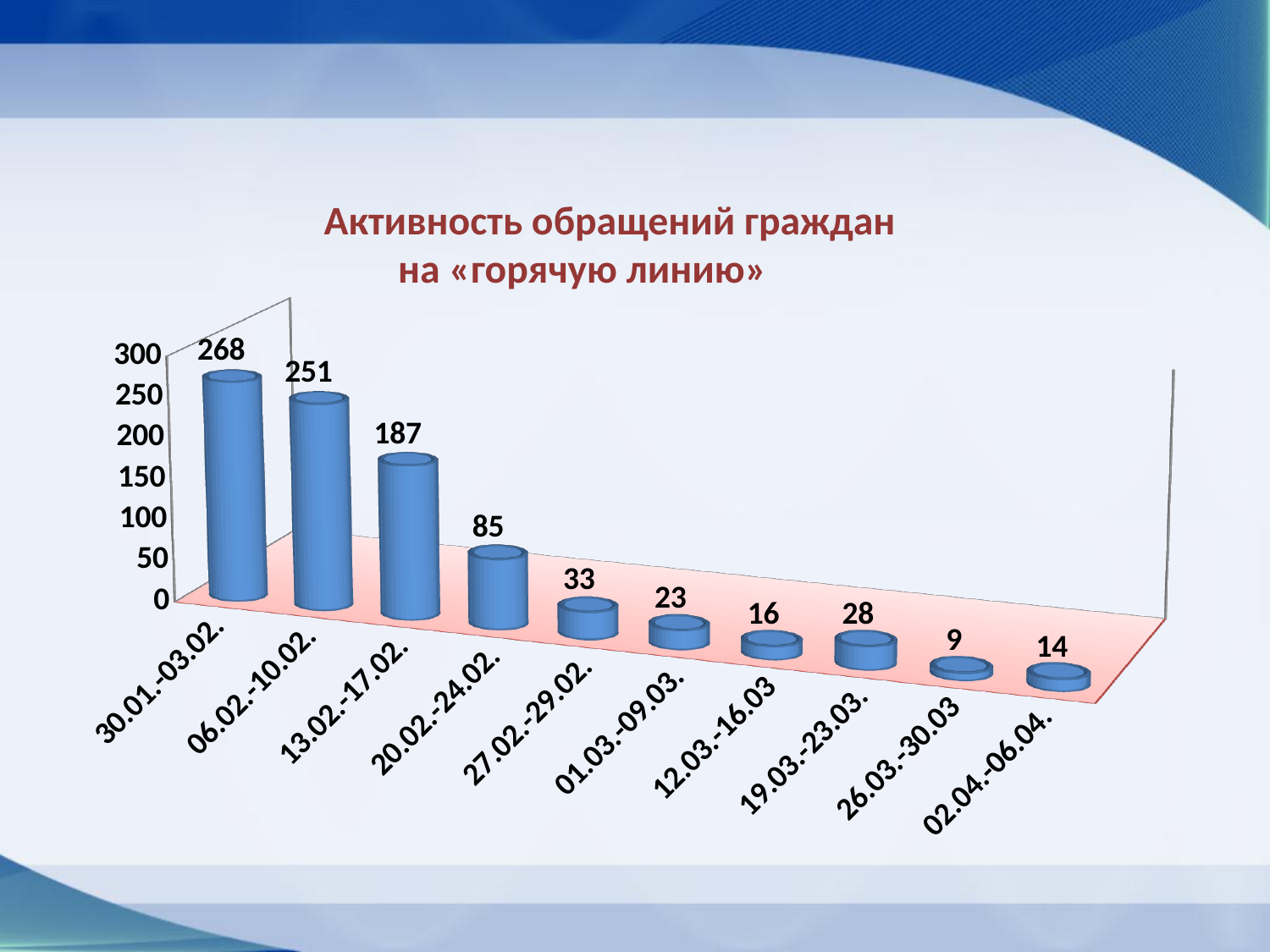
What is the value for the period 13.02.-17.02.? 187 Which period has the highest value? 30.01.-03.02. Which period has the lowest value? 26.03.-30.03 What is the difference between the values for 30.01.-03.02. and 06.02.-10.02.? 17 What is the value for the period 19.03.-23.03.? 28 What is the title of the chart? Активность обращений граждан на «горячую линию» What is the value for the period 30.01.-03.02.? 268 Which is larger, the value for 12.03.-16.03 or the value for 19.03.-23.03.? 19.03.-23.03. How many periods are shown on the x axis? 10 Is the value for 20.02.-24.02. greater or less than 100? less What kind of chart is this? bar chart Do the values generally rise or fall from left to right along the x axis? fall